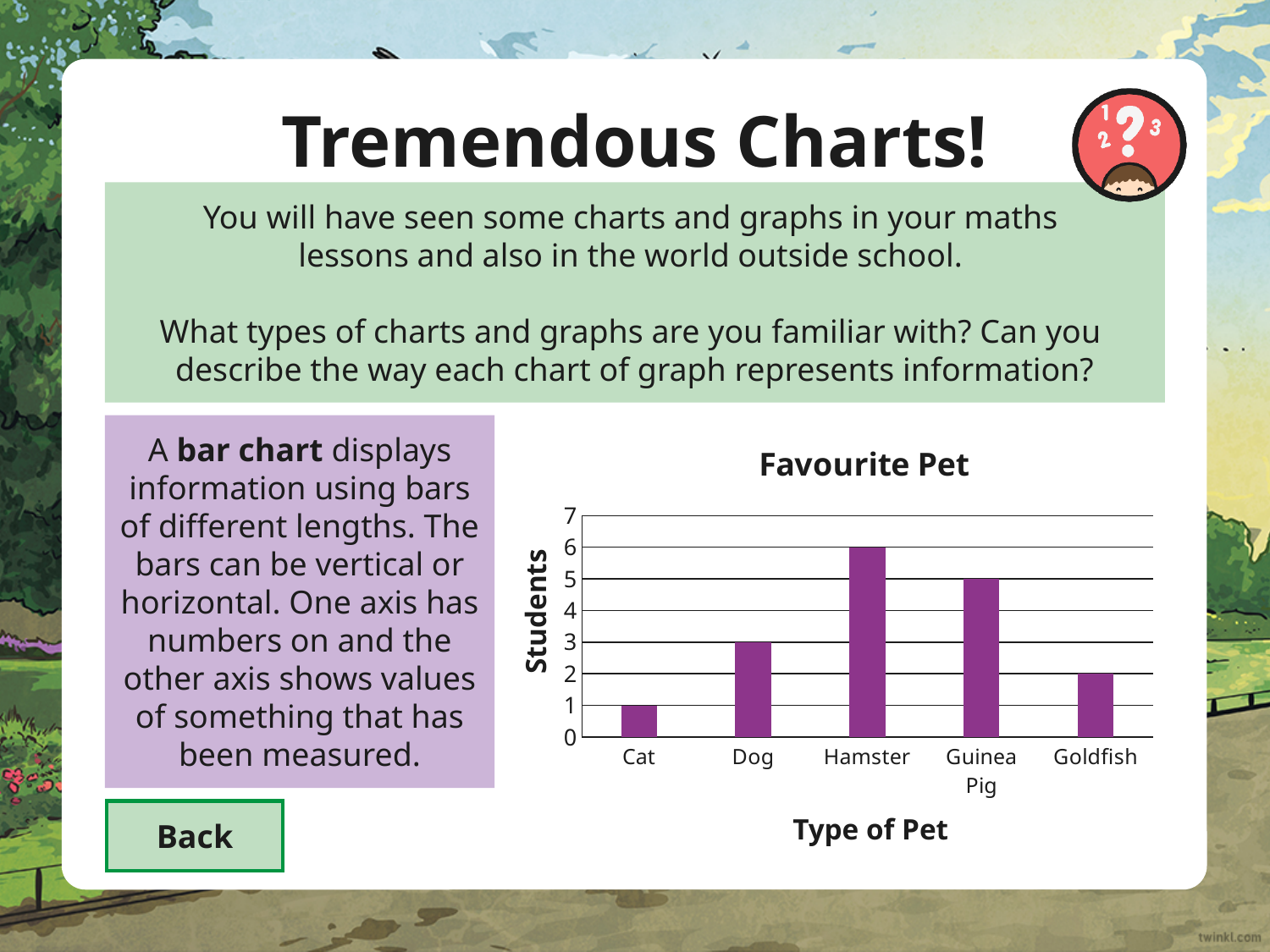
What is the title of the chart? Favourite Pet Which pet has the highest number of students? Hamster What is the difference between the number of students who chose Hamster and the number who chose Cat? 5 Which pet has the lowest number of students? Cat Which has more students, Guinea Pig or Dog? Guinea Pig How many types of pet are shown on the x axis? 5 What is the label on the vertical axis? Students How many students chose Dog as their favourite pet? 3 How many students chose Goldfish as their favourite pet? 2 What type of chart is shown on the slide? bar chart Is the value for Guinea Pig greater or less than 4? greater How many students chose Hamster as their favourite pet? 6